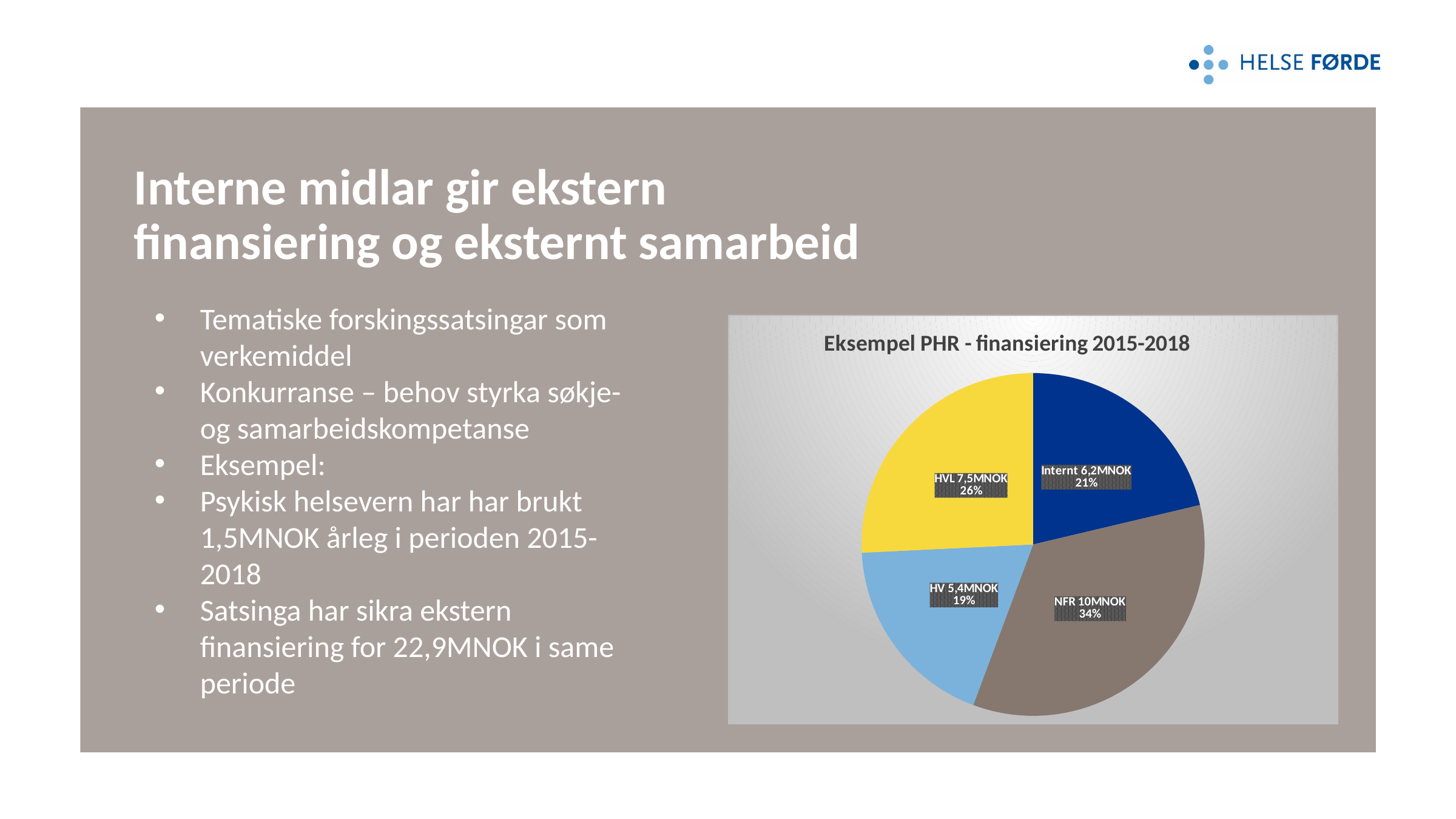
How many slices does the pie chart have? 4 What amount is shown for HVL? 7,5MNOK What share of the pie does HV represent? 19% What colour is the NFR slice? Brown What is the difference in percentage points between the NFR share and the HV share? 15 What kind of chart is shown on the slide? Pie chart What amount is shown for Internt? 6,2MNOK What share of the pie does NFR represent? 34% Which is larger, the share for HVL or the share for Internt? HVL Which slice is the smallest? HV Which slice is the largest? NFR What is the title of the chart? Eksempel PHR - finansiering 2015-2018